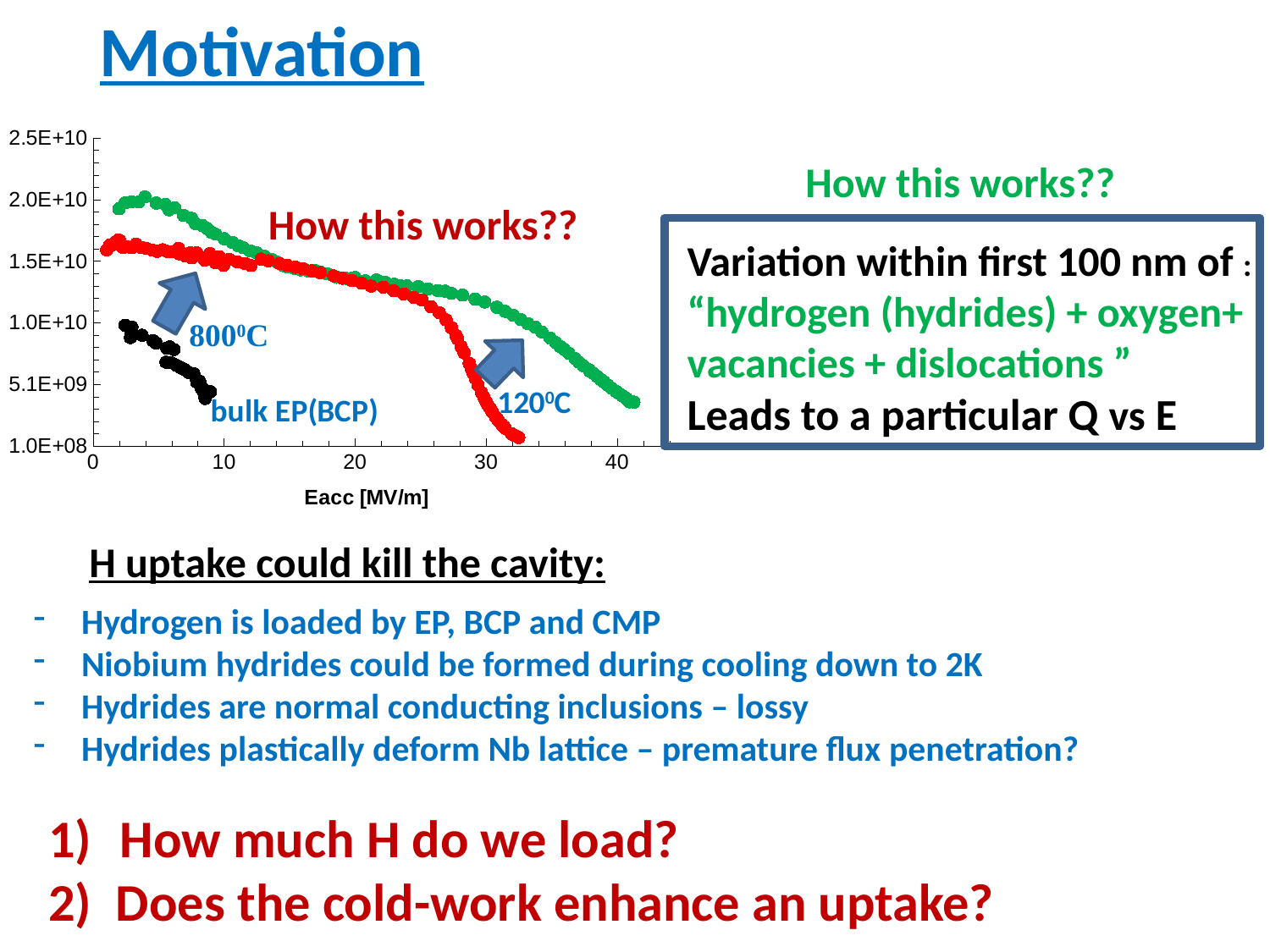
What is the label of the x axis of the chart? Eacc [MV/m] How many data series are plotted on the chart? 3 Is the value of the 120⁰C series at Eacc of 10 MV/m greater or less than 1.5E+10? greater Is the value of the 800⁰C series at Eacc of 32 MV/m greater or less than 5.1E+09? less Which series has the lowest values at low Eacc (around 5 MV/m)? bulk EP(BCP) At Eacc of about 5 MV/m, which series has the higher value, 800⁰C or bulk EP(BCP)? 800⁰C Do the plotted values rise or fall as Eacc increases? fall What kind of chart is shown on the slide? scatter chart Which series extends to the highest Eacc value? 120⁰C Is the value of the 120⁰C series at Eacc of 30 MV/m greater or less than 1.5E+10? less At Eacc of about 5 MV/m, which series has the higher value, 120⁰C or 800⁰C? 120⁰C What colour are the points of the 800⁰C series? red